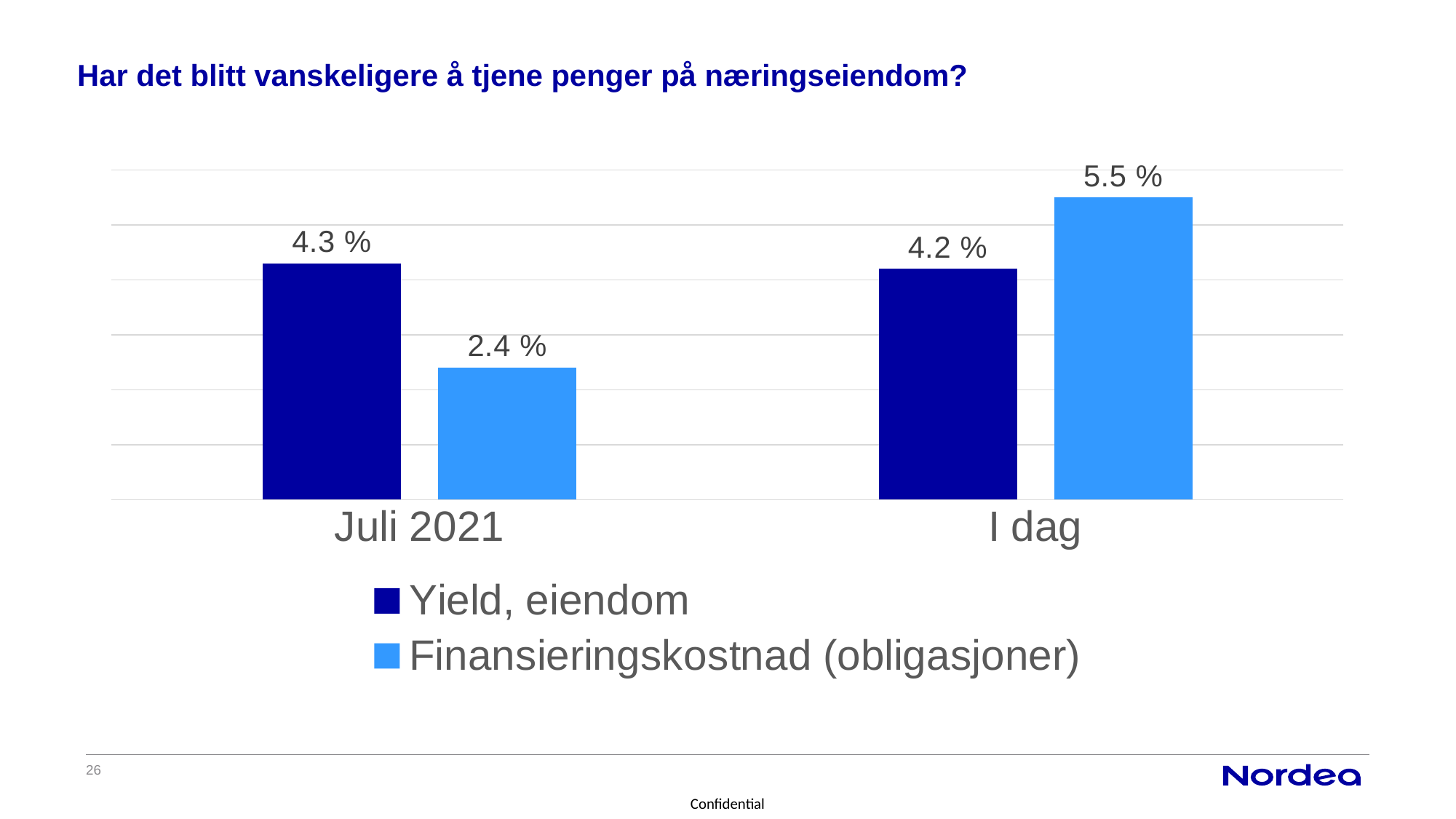
What is the value of Finansieringskostnad (obligasjoner) for Juli 2021? 2.4 % Which bar has the lowest value on the chart? Finansieringskostnad (obligasjoner), Juli 2021 What is the value of Yield, eiendom for I dag? 4.2 % What kind of chart is shown on the slide? Bar chart How many categories are shown on the x axis? 2 How many series does the legend list? 2 What is the value of Yield, eiendom for Juli 2021? 4.3 % What is the difference between Finansieringskostnad (obligasjoner) and Yield, eiendom for I dag? 1.3 % Which bar has the highest value on the chart? Finansieringskostnad (obligasjoner), I dag What is the difference between Yield, eiendom and Finansieringskostnad (obligasjoner) for Juli 2021? 1.9 % For I dag, which is larger: Yield, eiendom or Finansieringskostnad (obligasjoner)? Finansieringskostnad (obligasjoner) What is the value of Finansieringskostnad (obligasjoner) for I dag? 5.5 %